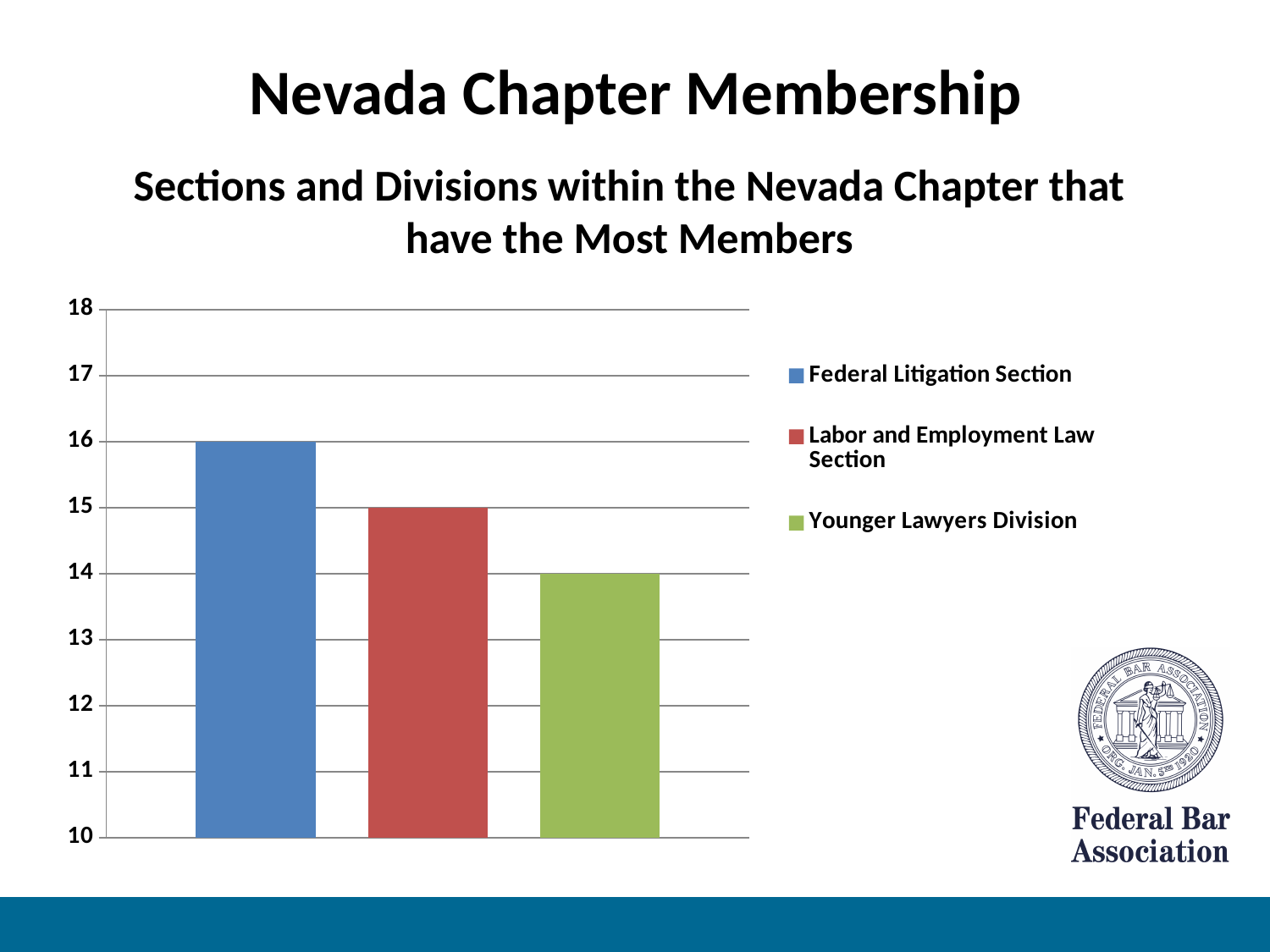
Which section or division has the lowest value? Younger Lawyers Division What is the value for the Labor and Employment Law Section? 15 Is the value for the Younger Lawyers Division greater or less than 15? less What kind of chart is shown on the slide? bar chart What is the difference between the Federal Litigation Section and the Younger Lawyers Division? 2 What is the value for the Younger Lawyers Division? 14 Which section or division has the highest value? Federal Litigation Section What is the value for the Federal Litigation Section? 16 How many series does the legend list? 3 What is the difference between the Federal Litigation Section and the Labor and Employment Law Section? 1 Which is larger, the Labor and Employment Law Section or the Younger Lawyers Division? Labor and Employment Law Section What colour is the bar for the Younger Lawyers Division? green